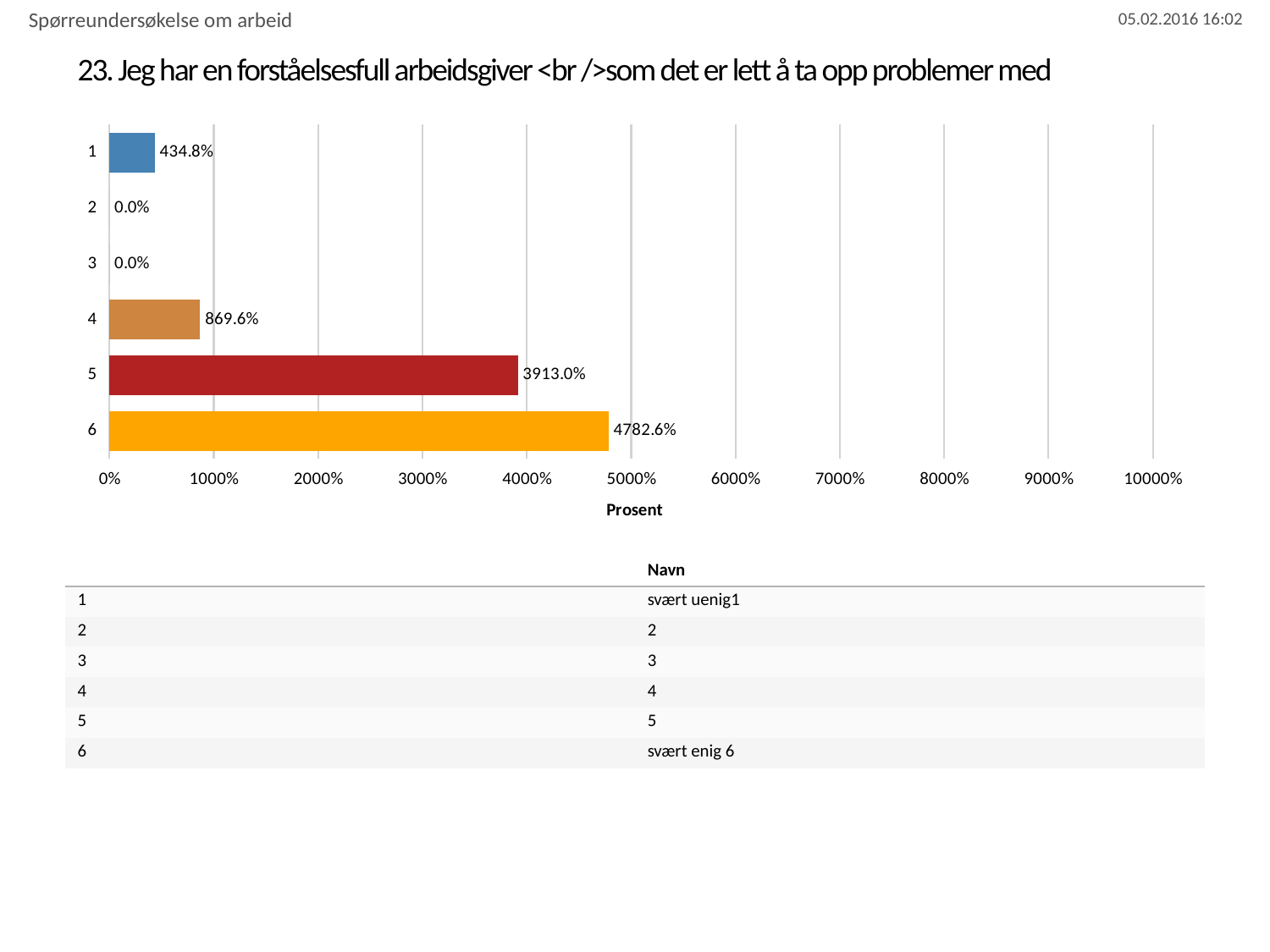
What kind of chart is shown on the slide? bar chart How many categories are shown on the chart? 6 What is the value for category 1? 434.8% What is the value for category 6? 4782.6% What is the value for category 4? 869.6% What is the label of the horizontal axis? Prosent Which category has the highest value? 6 What is the value for category 5? 3913.0% What is the difference between the values for category 6 and category 5? 869.6% Is the value for category 5 greater or less than 3000%? greater Which is larger, the value for category 4 or the value for category 1? 4 What is the difference between the values for category 4 and category 1? 434.8%